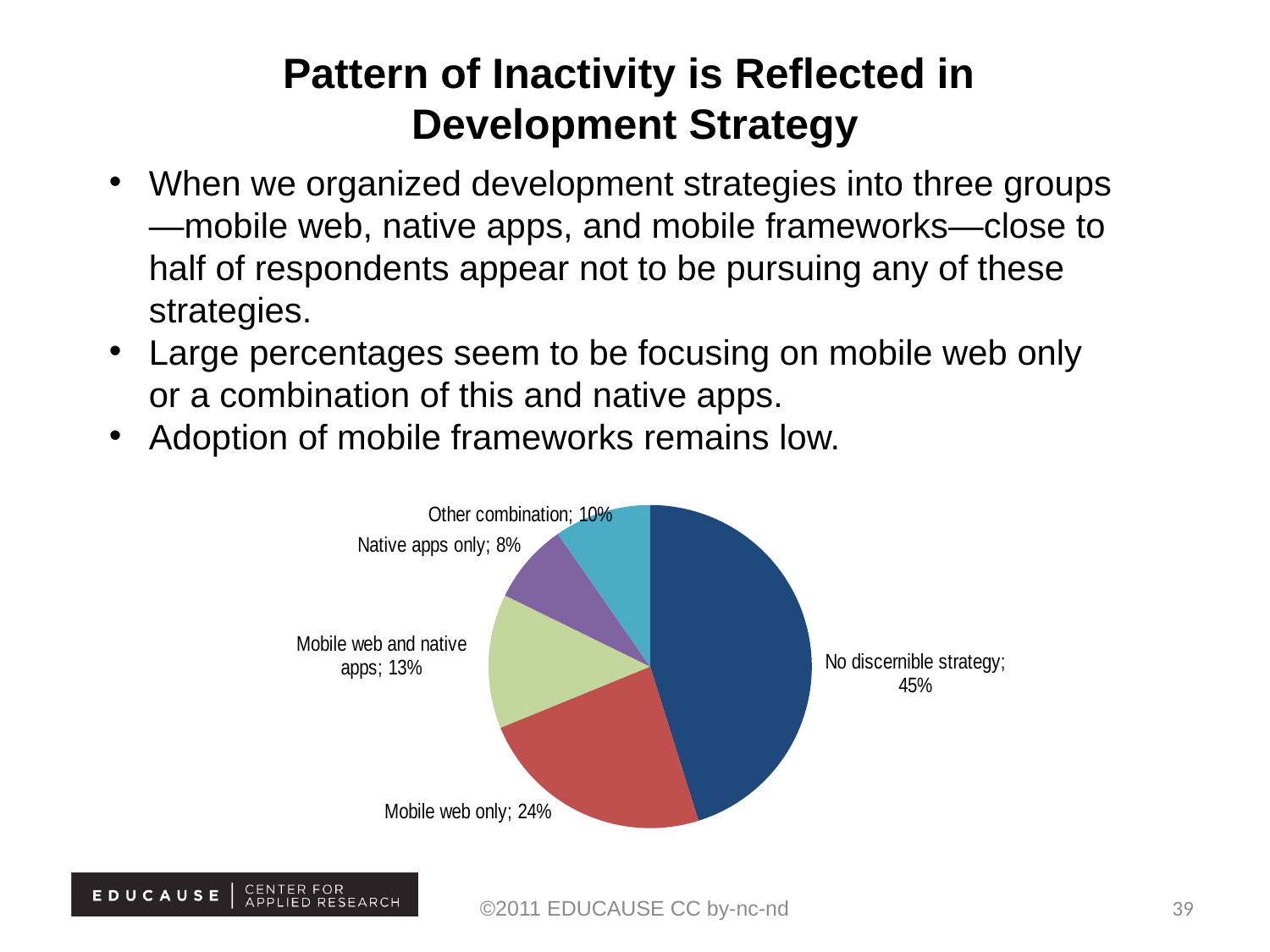
What is the difference between the shares for No discernible strategy and Mobile web only? 21% What is the value for Mobile web and native apps? 13% Which is larger, the share for Other combination or the share for Native apps only? Other combination Which category has the smallest share of the pie? Native apps only What is the value for Other combination? 10% What percentage of respondents have no discernible strategy? 45% Which category has the largest share of the pie? No discernible strategy How many slices does the pie chart have? 5 What is the value for Native apps only? 8% What kind of chart is shown on the slide? pie chart What is the value for Mobile web only? 24% What colour is the slice for Mobile web only? red